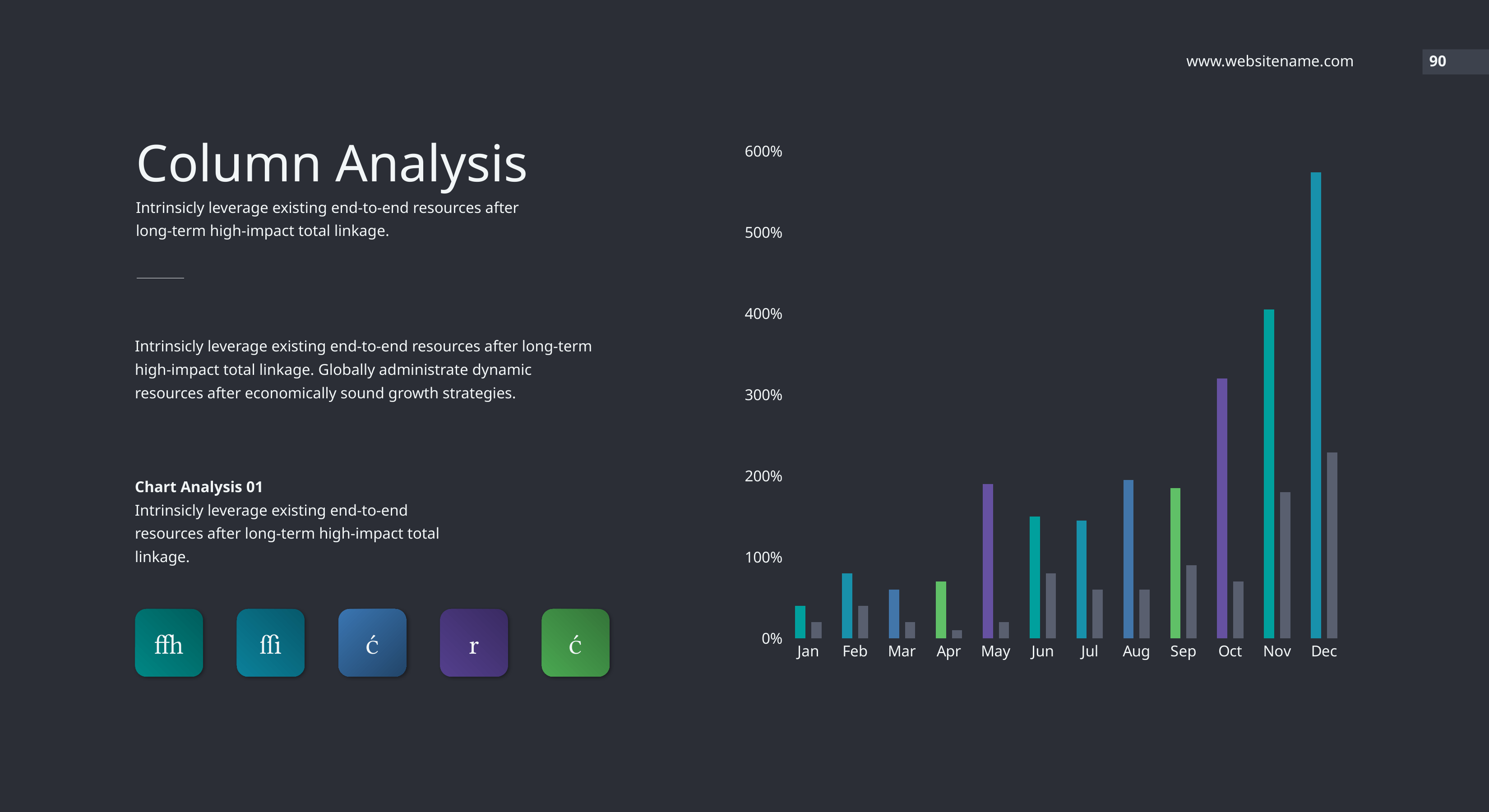
Is the grey bar for Dec greater or less than 200%? greater Is the coloured bar for Oct greater or less than 400%? less Which month has the shortest coloured (first) bar in the chart? Jan Is the coloured bar for Jan greater or less than 100%? less Which month has the tallest bar in the chart? Dec How many months are shown on the x axis of the chart? 12 What is the title of the slide containing the chart? Column Analysis What kind of chart is shown on the slide? bar chart Do the coloured bars generally rise or fall from Jan to Dec? rise Which is larger, the coloured bar for Oct or the coloured bar for Sep? Oct